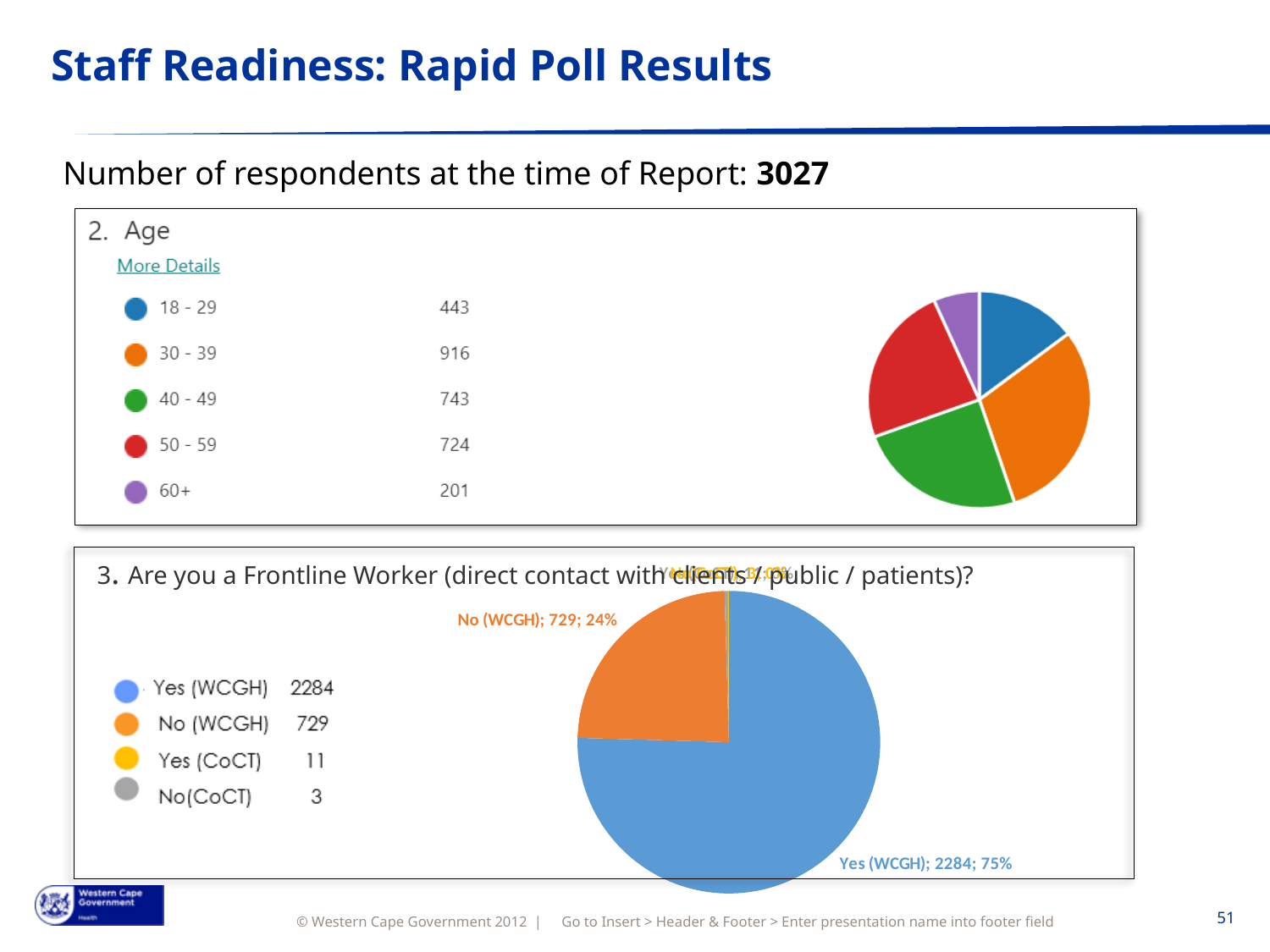
In the Age chart, what is the difference between the 40 - 49 and 50 - 59 groups? 19 In the Frontline Worker chart, what is the difference between Yes (WCGH) and No (WCGH)? 1555 In the Age chart, which age group has the fewest respondents? 60+ In the Age chart, how many respondents are aged 60+? 201 How many age groups are shown in the Age chart? 5 In the Frontline Worker chart, how many respondents answered Yes (WCGH)? 2284 In the Age chart, which has more respondents: 18 - 29 or 40 - 49? 40 - 49 In the Age chart, how many respondents are in the 30 - 39 age group? 916 What type of chart is used for the Age question? Pie chart In the Frontline Worker chart, which category has the smallest value? No(CoCT) In the Age chart, which age group has the most respondents? 30 - 39 In the Frontline Worker chart, what share of the pie is No (WCGH)? 24%